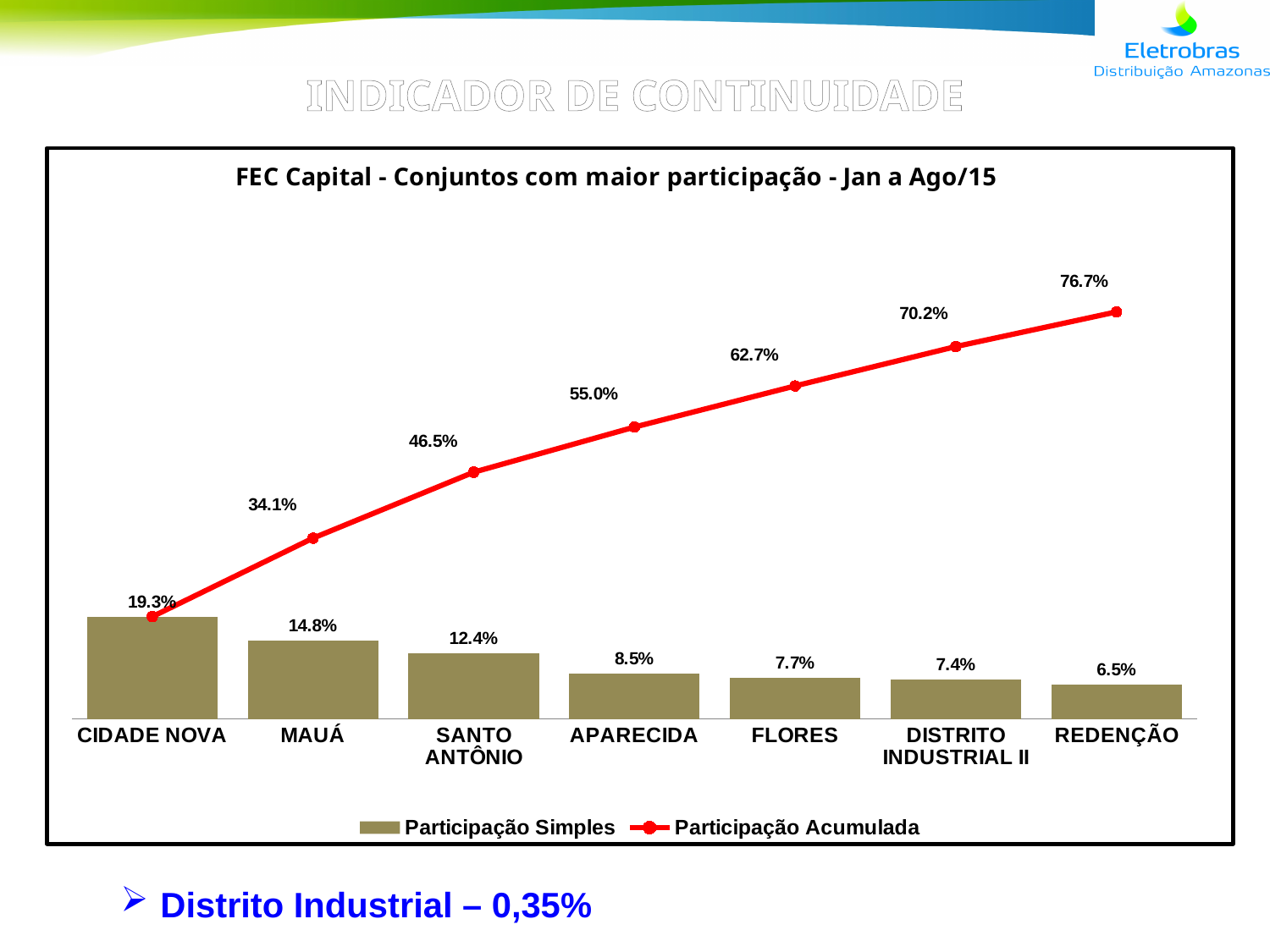
What is the Participação Acumulada value at APARECIDA? 55.0% Which category has the lowest Participação Simples? REDENÇÃO Does the Participação Acumulada line rise or fall from left to right? rise How many series does the legend list? 2 What is the Participação Acumulada value at REDENÇÃO? 76.7% Which has a larger Participação Simples value, FLORES or APARECIDA? APARECIDA Which category has the highest Participação Simples? CIDADE NOVA What is the difference between the Participação Simples values for CIDADE NOVA and MAUÁ? 4.5% What is the Participação Simples value for CIDADE NOVA? 19.3% What is the Participação Simples value for SANTO ANTÔNIO? 12.4% What is the title of the chart? FEC Capital - Conjuntos com maior participação - Jan a Ago/15 How many categories are shown on the x axis? 7